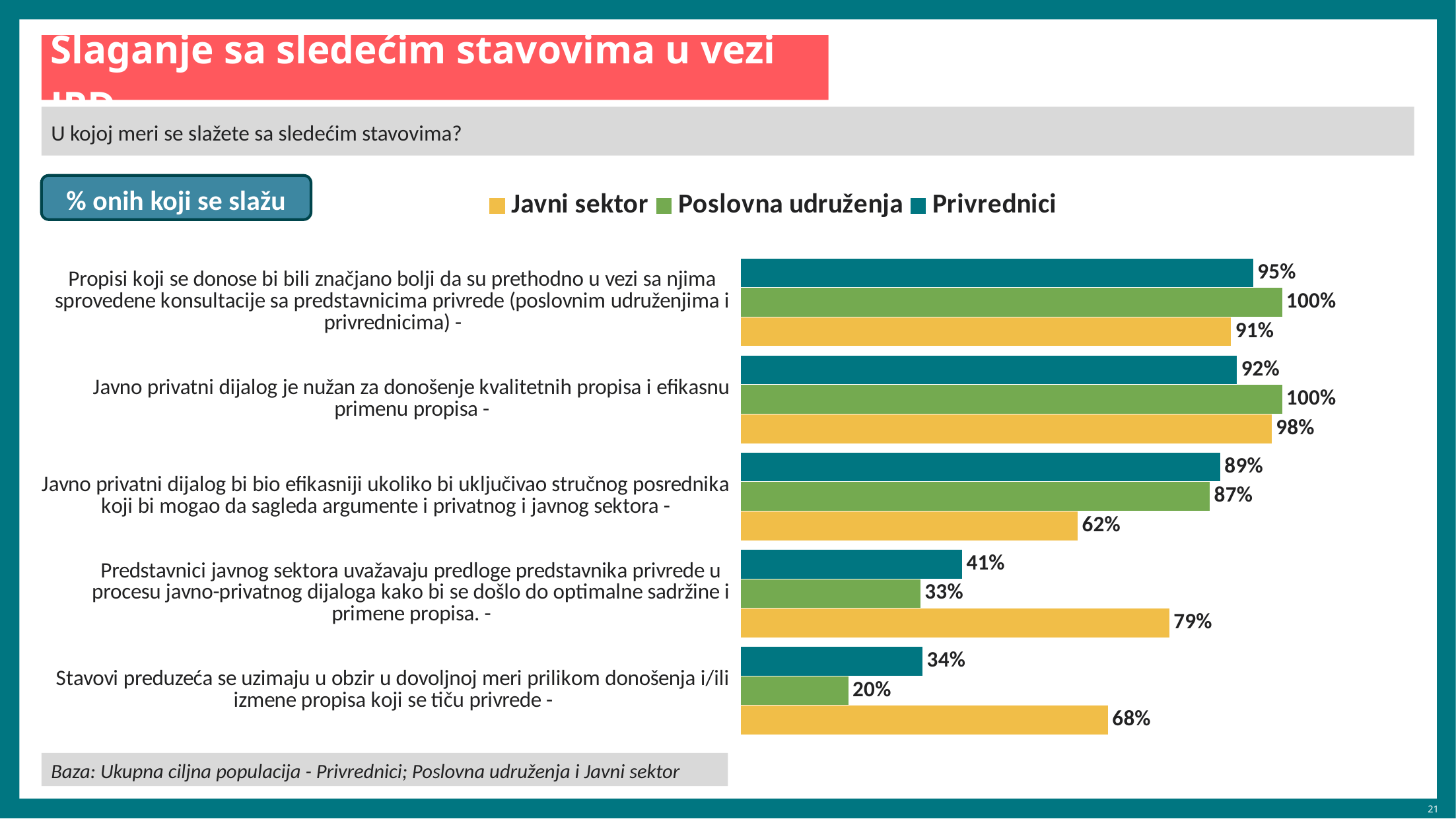
Which colour represents Privrednici in the legend? teal (dark green-blue) What is the difference between the Javni sektor and Poslovna udruženja values for the statement 'Stavovi preduzeća se uzimaju u obzir u dovoljnoj meri...'? 48% For the statement 'Javno privatni dijalog je nužan za donošenje kvalitetnih propisa i efikasnu primenu propisa', which is larger: the Javni sektor value or the Privrednici value? Javni sektor What is the difference between the Privrednici and Javni sektor values for the statement 'Javno privatni dijalog bi bio efikasniji ukoliko bi uključivao stručnog posrednika...'? 27% How many series does the legend list? 3 What is the value for Poslovna udruženja for the statement 'Javno privatni dijalog bi bio efikasniji ukoliko bi uključivao stručnog posrednika...'? 87% What is the value for Privrednici for the statement 'Stavovi preduzeća se uzimaju u obzir u dovoljnoj meri prilikom donošenja i/ili izmene propisa koji se tiču privrede'? 34% How many statements (categories) are plotted in the chart? 5 What kind of chart is shown on the slide? bar chart What is the value for Javni sektor for the statement 'Predstavnici javnog sektora uvažavaju predloge predstavnika privrede u procesu javno-privatnog dijaloga...'? 79% Which series has the highest value for the statement 'Predstavnici javnog sektora uvažavaju predloge predstavnika privrede...'? Javni sektor Which series has the lowest value for the statement 'Stavovi preduzeća se uzimaju u obzir u dovoljnoj meri...'? Poslovna udruženja